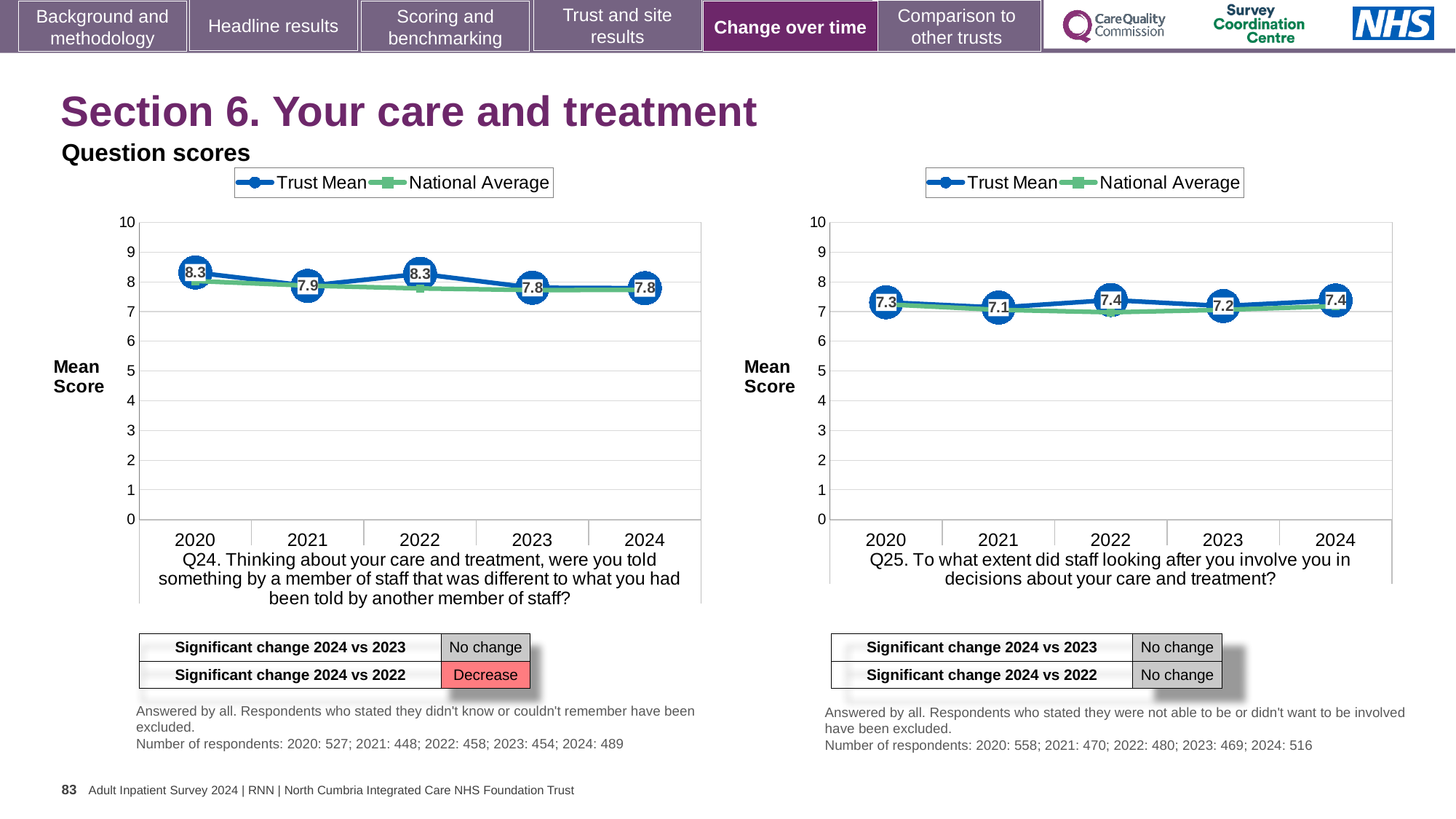
In the Q24 chart on the left, what is the Trust Mean score for 2024? 7.8 In the Q25 chart on the right, what is the Trust Mean score for 2023? 7.2 In the Q25 chart on the right, what is the difference between the Trust Mean scores for 2024 and 2021? 0.3 How many series does the legend of the Q24 chart on the left list? 2 How many years are plotted on the x axis of the Q25 chart on the right? 5 In the Q24 chart on the left, what is the difference between the Trust Mean scores for 2020 and 2024? 0.5 In the Q25 chart on the right, what is the Trust Mean score for 2022? 7.4 In the Q24 chart on the left, is the National Average for 2020 greater or less than 7? greater In the Q25 chart on the right, which year has the lowest Trust Mean score? 2021 In the Q24 chart on the left, is the Trust Mean score higher in 2020 or 2021? 2020 What type of chart is the Q25 chart on the right? Line chart In the Q24 chart on the left, what is the Trust Mean score for 2020? 8.3